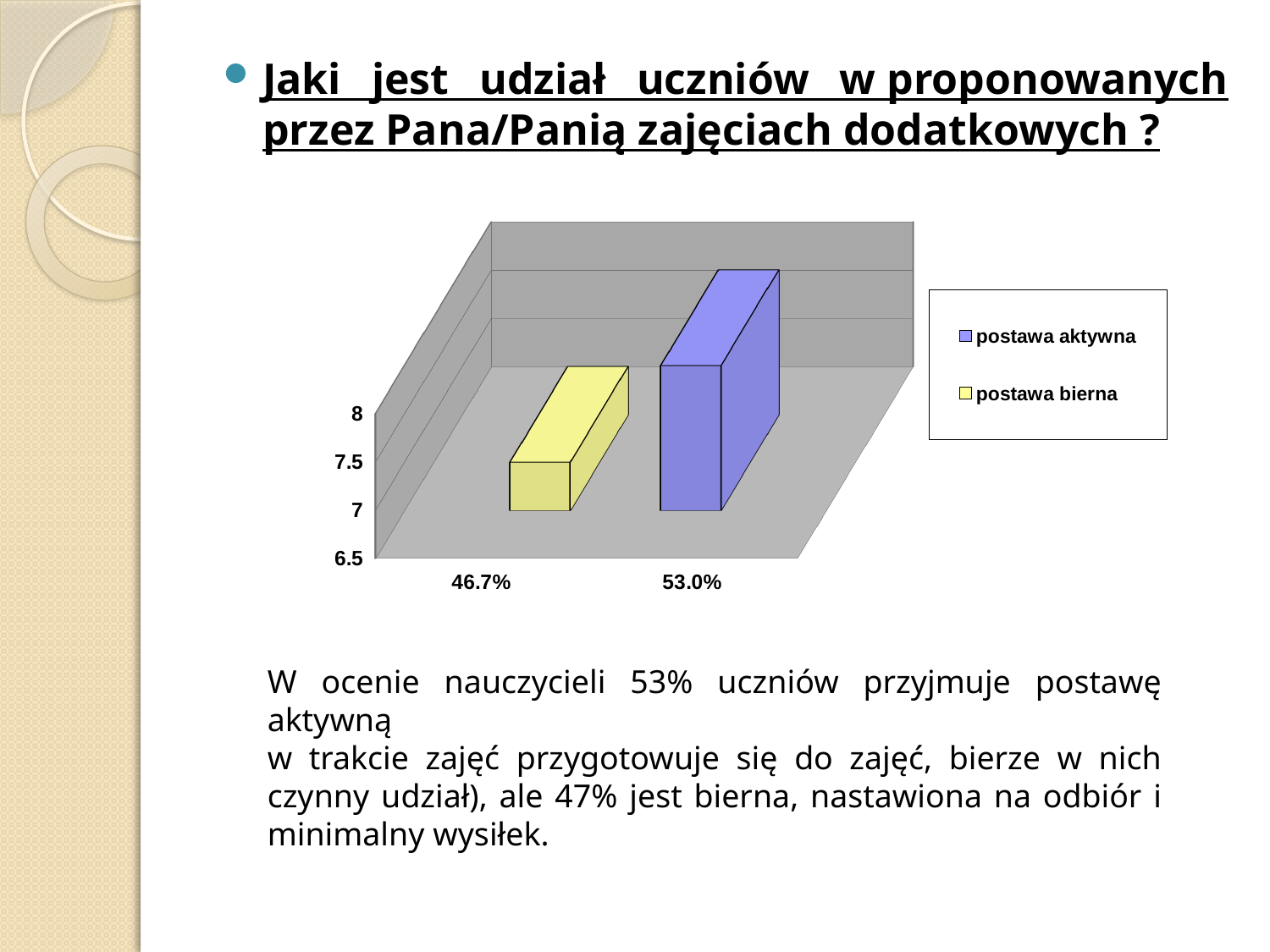
What percentage label appears under the bar for postawa bierna? 46.7% Is the value for postawa bierna greater or less than 7.5? less What colour is the bar for postawa bierna? yellow What kind of chart is shown on the slide? bar chart How many series does the chart legend list? 2 Is the value for postawa aktywna greater or less than 7.5? greater How many bars are plotted in the chart? 2 Which series has the tallest bar in the chart? postawa aktywna Which series has the shortest bar in the chart? postawa bierna What percentage label appears under the bar for postawa aktywna? 53.0% What colour is the bar for postawa aktywna? blue Which series has the taller bar, postawa aktywna or postawa bierna? postawa aktywna